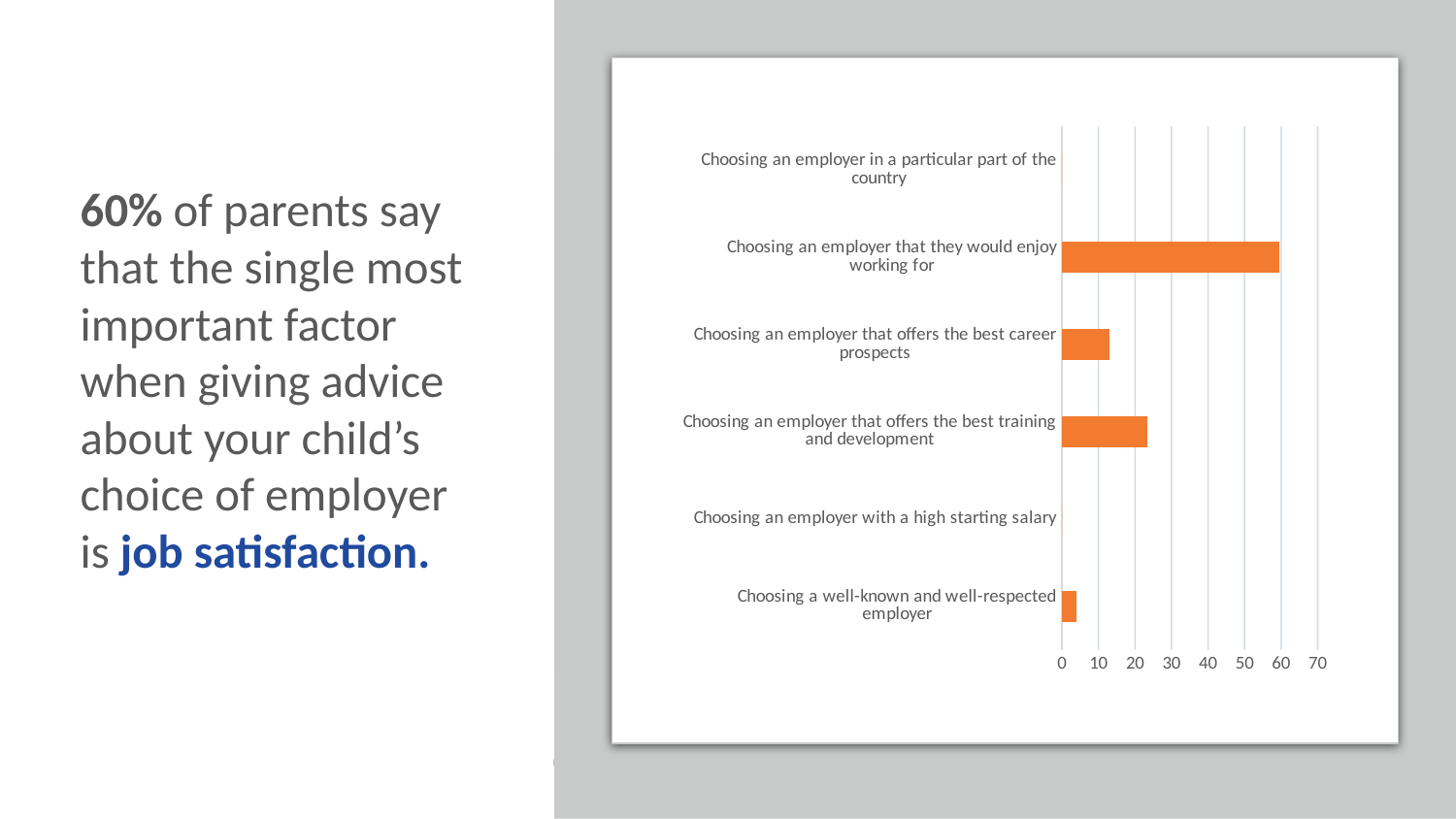
Which category has the highest value on the chart? Choosing an employer that they would enjoy working for Is the value for "Choosing an employer that they would enjoy working for" greater or less than 50? greater Which is larger: the value for "Choosing an employer that offers the best training and development" or the value for "Choosing an employer that offers the best career prospects"? Choosing an employer that offers the best training and development What colour are the bars on the chart? orange What is the highest value shown on the chart's horizontal axis? 70 How many categories are shown on the chart? 6 Which is larger: the value for "Choosing an employer that they would enjoy working for" or the value for "Choosing a well-known and well-respected employer"? Choosing an employer that they would enjoy working for Is the value for "Choosing a well-known and well-respected employer" greater or less than 10? less Is the value for "Choosing an employer that offers the best career prospects" greater or less than 20? less What kind of chart is shown on the slide? bar chart